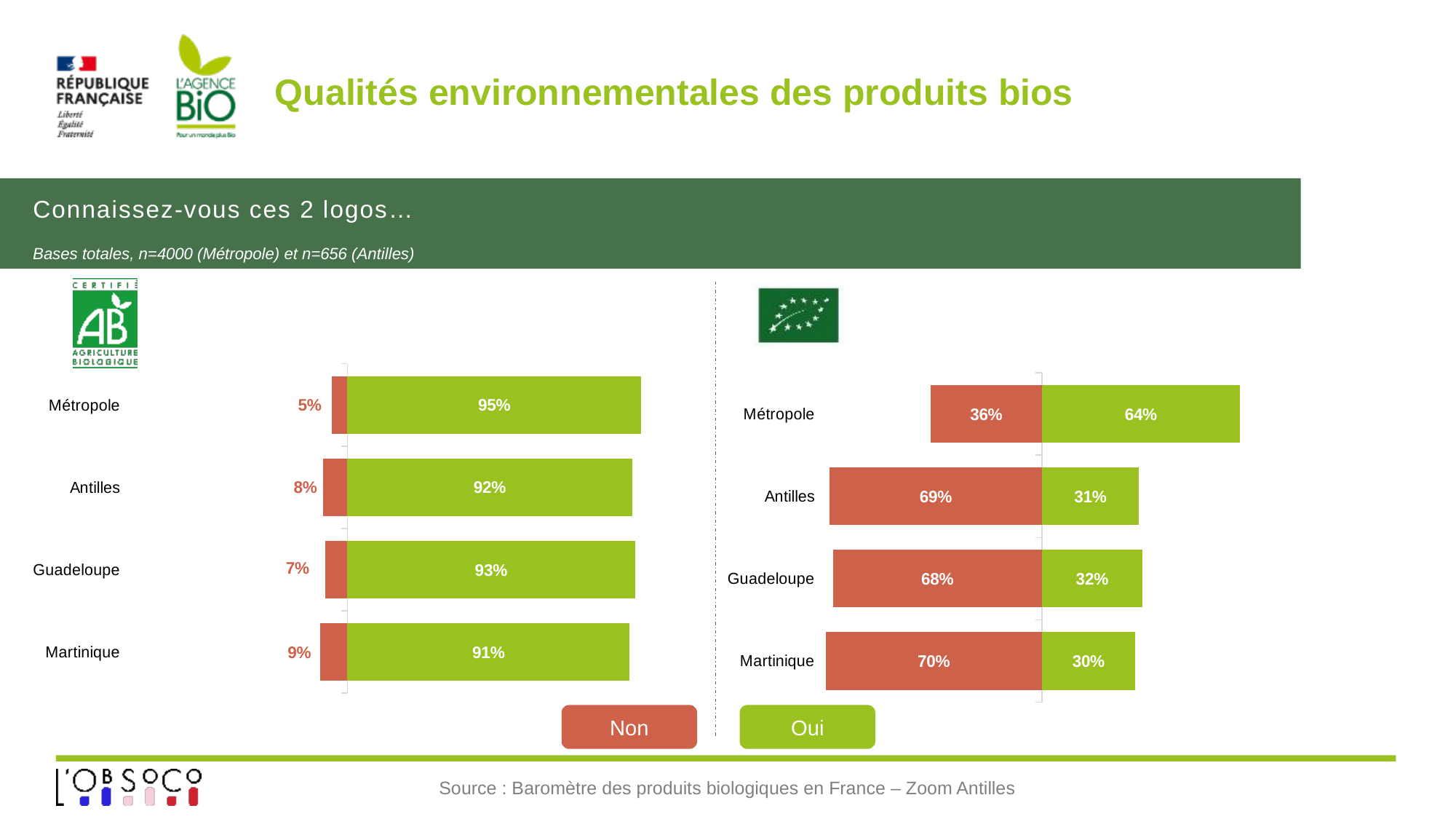
In the right chart (EU organic leaf logo), what percentage of Métropole respondents answered Oui? 64% How many series does the legend at the bottom of the slide list? 2 In the right chart (EU organic leaf logo), what is the difference between the Oui percentages for Métropole and Martinique? 34% In the right chart (EU organic leaf logo), which region has the highest Non percentage? Martinique In the left chart (AB logo), what percentage of Martinique respondents answered Non? 9% What type of chart is used on the right side of the slide (EU organic leaf logo)? Bar chart How many regions are shown in the left chart (AB logo)? 4 In the left chart (AB logo), which region has the lowest Oui percentage? Martinique In the left chart (AB logo), which is larger: the Non percentage for Antilles or for Guadeloupe? Antilles In the left chart (AB logo), what percentage of Métropole respondents answered Oui? 95% Which colour represents the Oui answer in the charts? Green In the right chart (EU organic leaf logo), what percentage of Antilles respondents answered Non? 69%